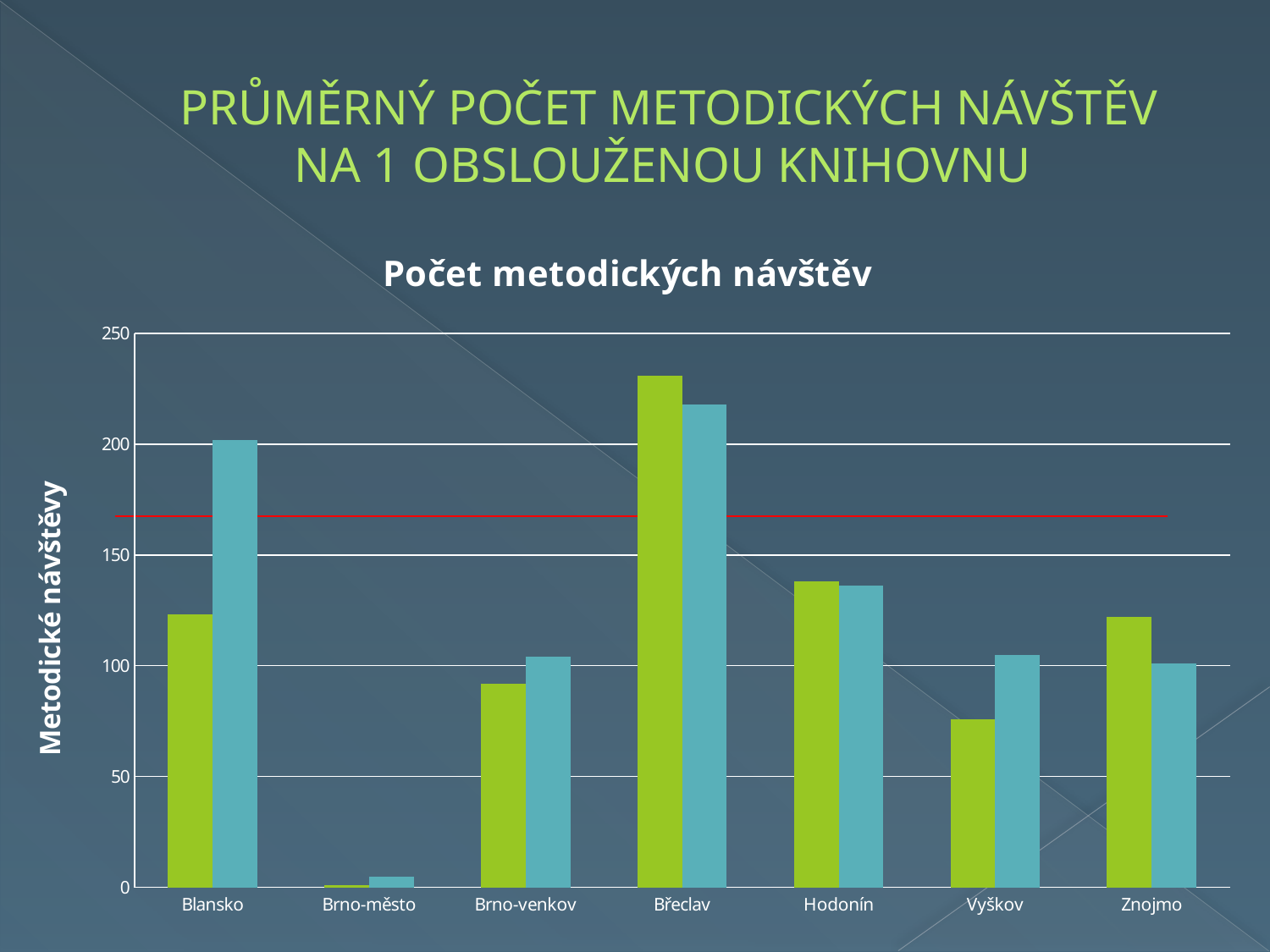
Is the green bar for Blansko greater or less than 100? greater What kind of chart is shown on the slide? bar chart Is the green bar for Břeclav greater or less than 200? greater Which category has the lowest blue bar? Brno-město For Znojmo, which bar is taller, the green one or the blue one? the green one For Blansko, which bar is taller, the green one or the blue one? the blue one How many categories are shown on the x axis of the chart? 7 What is the title of the chart? Počet metodických návštěv Is the green bar for Vyškov greater or less than 100? less Which category has the highest green bar? Břeclav What is the label on the vertical axis of the chart? Metodické návštěvy